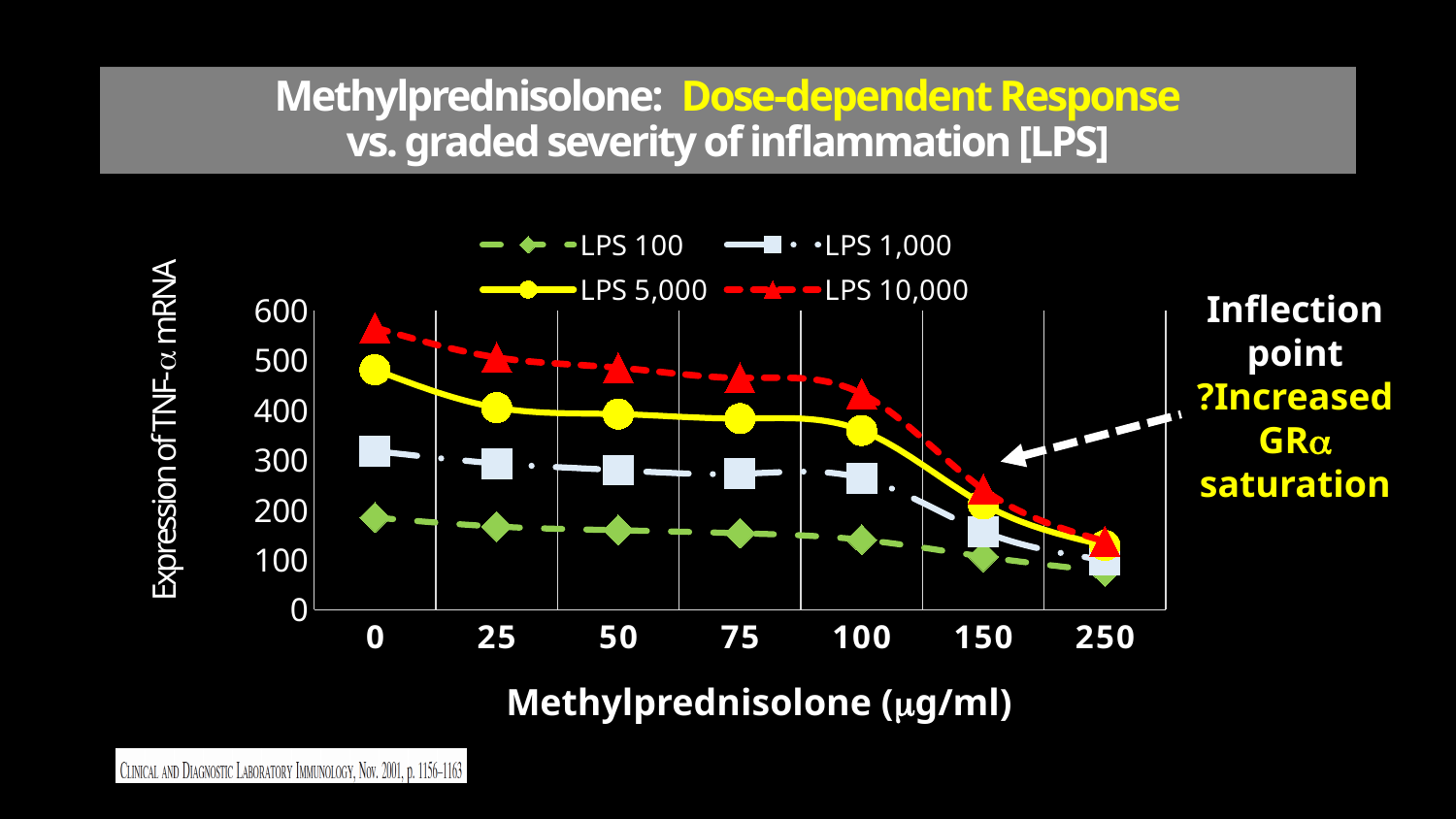
Is the value for LPS 1,000 at 0 µg/ml greater or less than 200? greater Is the value for LPS 10,000 at 0 µg/ml greater or less than 500? greater Does the LPS 5,000 series rise or fall as the methylprednisolone concentration increases? fall Is the value for LPS 100 at 0 µg/ml greater or less than 300? less Which series has the lowest TNF-α mRNA expression at 0 µg/ml methylprednisolone? LPS 100 What is the label of the x axis? Methylprednisolone (µg/ml) How many series does the legend list? 4 At 100 µg/ml methylprednisolone, which is larger: the value for LPS 5,000 or the value for LPS 1,000? LPS 5,000 How many methylprednisolone concentrations are plotted along the x axis? 7 Which series has the highest TNF-α mRNA expression at 0 µg/ml methylprednisolone? LPS 10,000 What kind of chart is shown on the slide? line chart